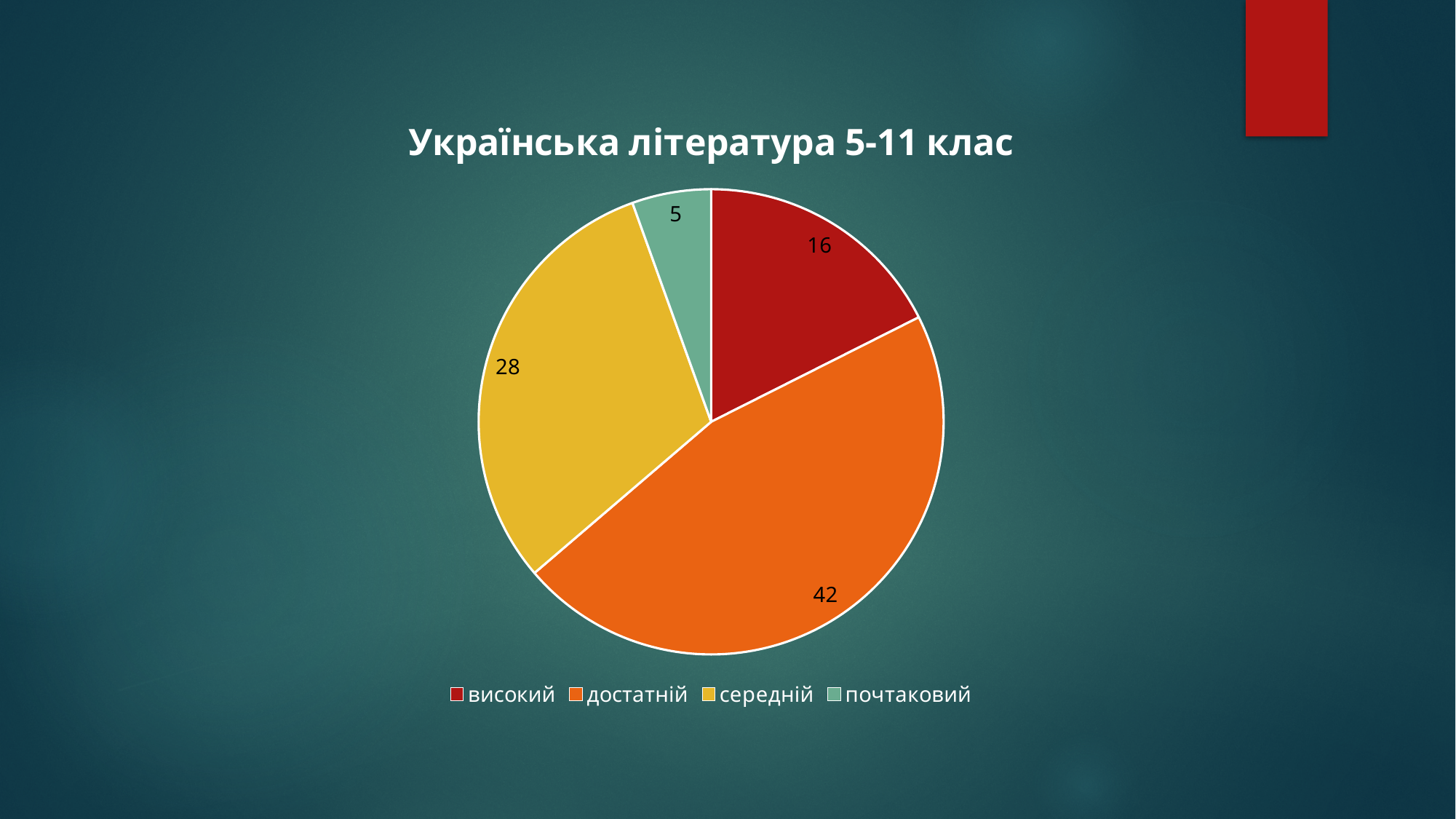
What is the value for the середній slice? 28 Which category has the largest slice? достатній How many categories does the legend list? 4 What is the value for the високий slice? 16 What is the difference between the достатній and середній values? 14 What is the title of the chart? Українська література 5-11 клас What is the sum of all four slice values? 91 What is the value for the достатній slice? 42 Which category has the smallest slice? почтаковий Which is larger, високий or середній? середній What is the value for the почтаковий slice? 5 What type of chart is shown on the slide? pie chart